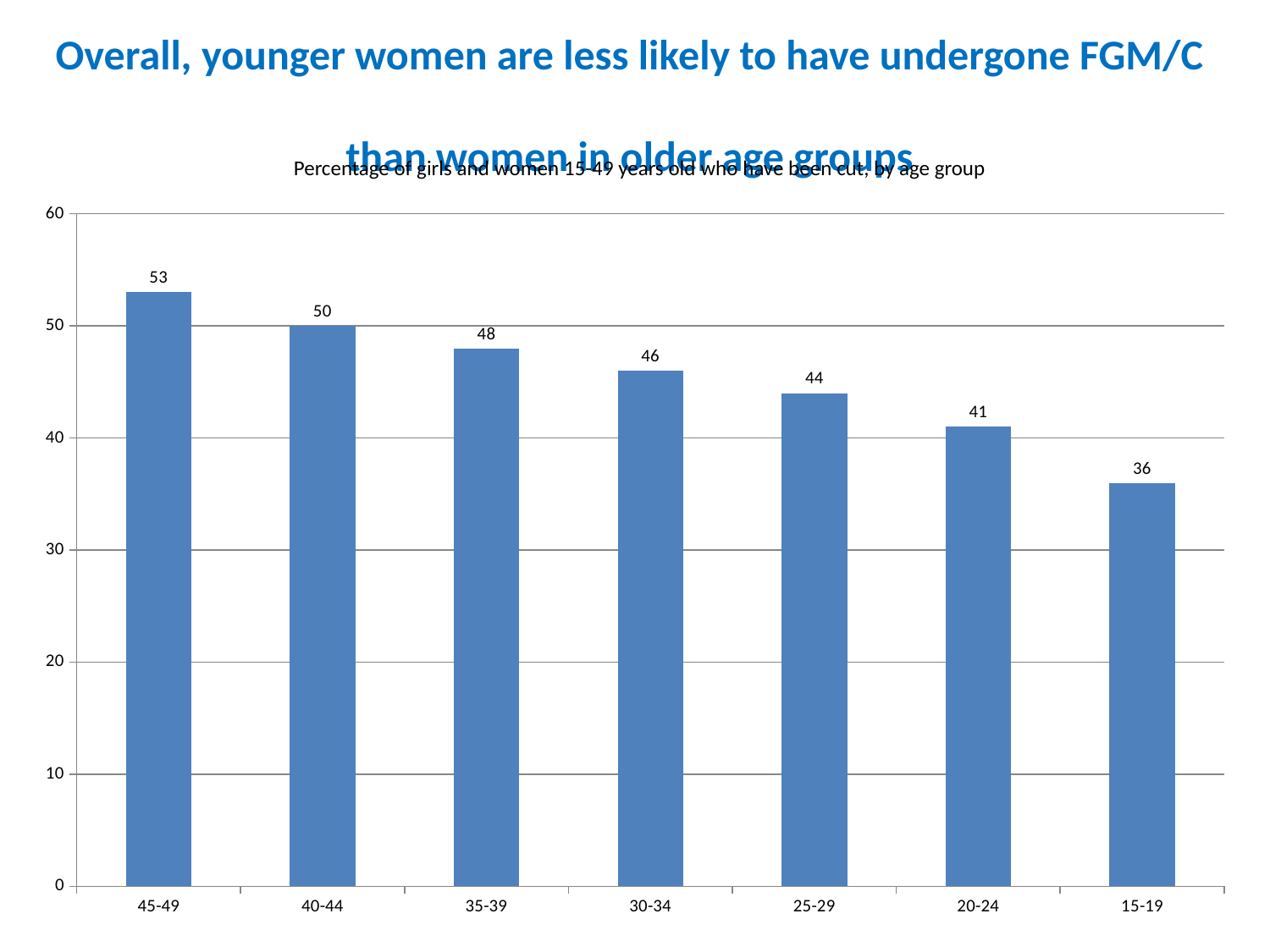
What kind of chart is shown on the slide? Bar chart What is the difference between the values for the 45-49 and 15-19 age groups? 17 Which age group has the highest value? 45-49 Which age group has the lowest value? 15-19 What is the difference between the values for the 35-39 and 20-24 age groups? 7 What is the value for the 45-49 age group? 53 Do the values rise or fall moving from left to right along the x axis? Fall Is the value for the 20-24 age group greater or less than 40? greater Which is larger, the value for 40-44 or the value for 25-29? 40-44 What is the value for the 15-19 age group? 36 How many age groups are shown on the chart? 7 What is the value for the 30-34 age group? 46